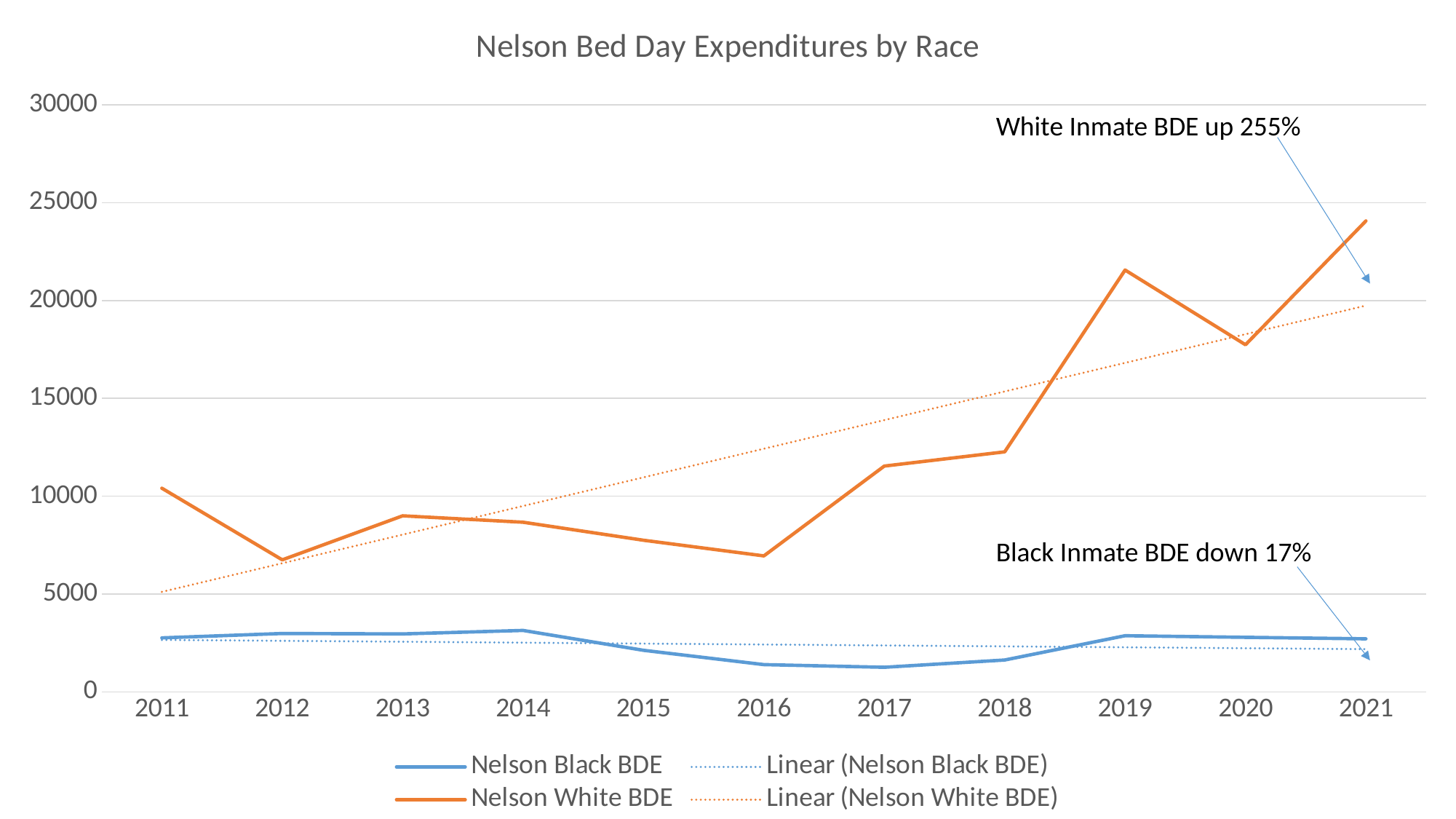
Is the value for Nelson White BDE in 2018 greater or less than 15000? less Is the value for Nelson White BDE in 2016 greater or less than 10000? less Is the value for Nelson White BDE in 2021 greater or less than 20000? greater How many series does the legend list? 4 How many years are shown on the x axis? 11 Which series has the larger value in 2021, Nelson Black BDE or Nelson White BDE? Nelson White BDE What kind of chart is shown on the slide? line chart In which year is Nelson White BDE highest? 2021 According to the annotation on the chart, by what percentage is White Inmate BDE up? 255% Does Nelson White BDE generally rise or fall from 2016 to 2021? rise